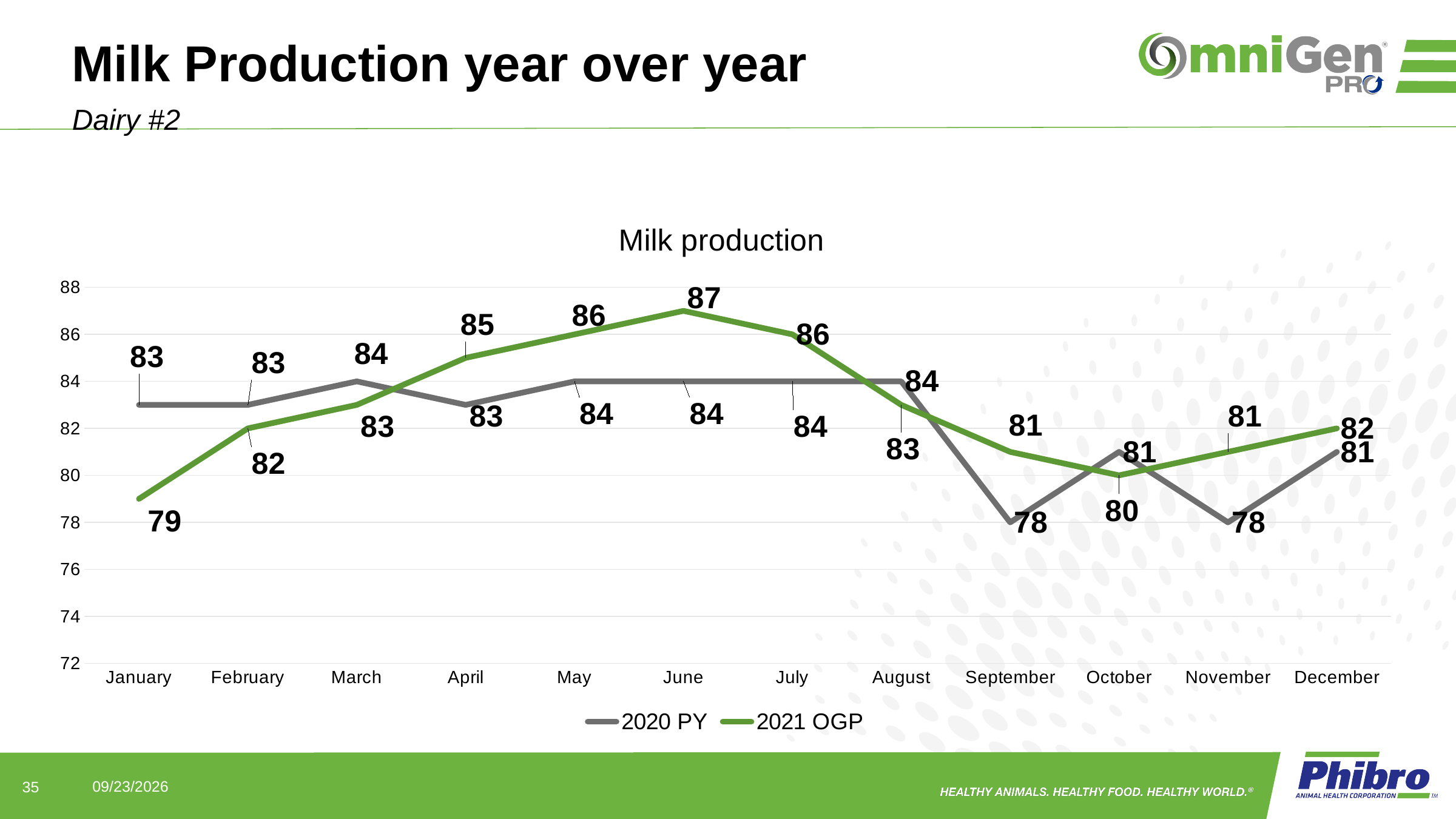
How many series does the legend list? 2 Does the 2021 OGP line rise or fall from January to June? rise In which month is the 2021 OGP value lowest? January What is the 2020 PY value for March? 84 In which month is the 2021 OGP value highest? June What is the difference between the 2021 OGP and 2020 PY values in June? 3 What kind of chart is shown on the slide? line chart In October, which series has the higher value, 2020 PY or 2021 OGP? 2020 PY What is the 2020 PY value for September? 78 What is the title of the chart? Milk production What is the 2021 OGP value for June? 87 How many months are plotted on the x axis? 12